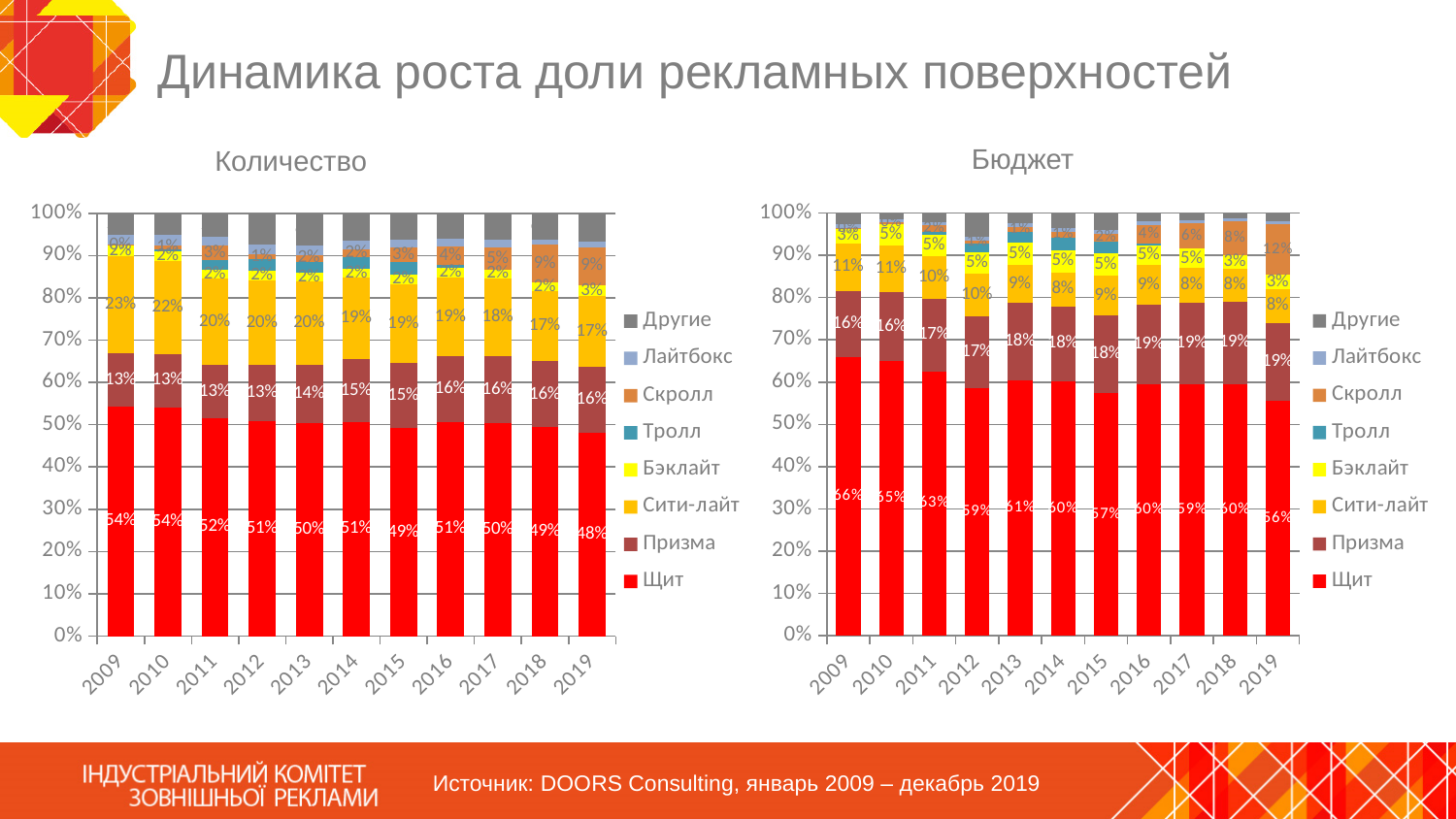
How many years are shown on the x axis of the Количество chart? 11 In the Бюджет chart, which year has the lowest value for Щит? 2019 In the Количество chart, what is the value for Щит in 2009? 54% How many series does the legend of the Бюджет chart list? 8 In the Количество chart, what is the value for Сити-лайт in 2019? 17% In the Количество chart, what is the difference between the Сити-лайт value in 2009 and in 2019? 6 percentage points In the Количество chart, which year has the highest value for Щит? 2009 and 2010 (54%) What kind of chart is the Количество chart? Stacked bar chart In the Количество chart, does the Призма share rise or fall from 2009 to 2019? Rises In the Бюджет chart, which is larger in 2009: Призма or Сити-лайт? Призма In the Бюджет chart, what is the value for Щит in 2019? 56% In the Бюджет chart, what is the value for Призма in 2016? 19%